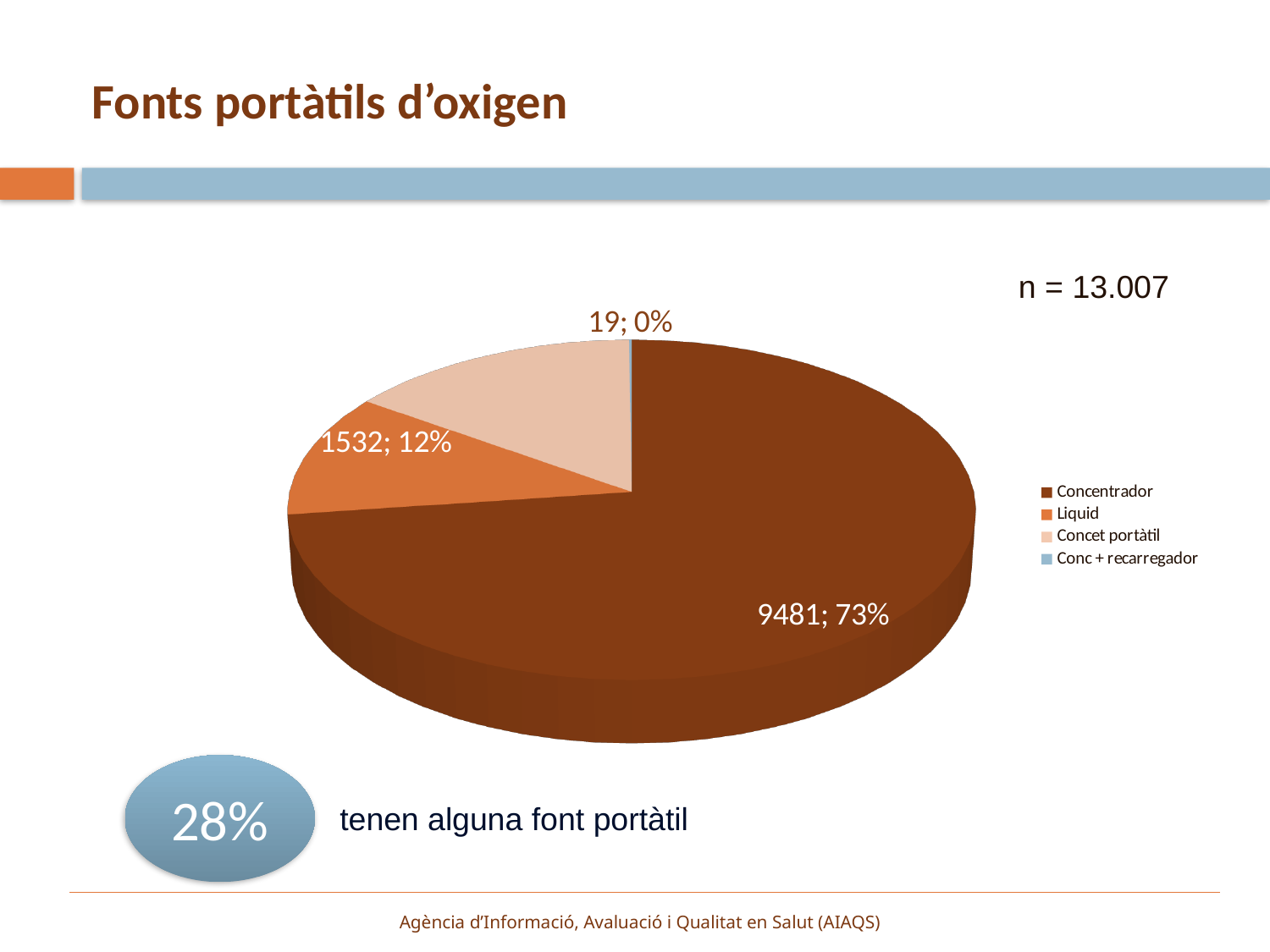
What value is shown for the Liquid slice? 1532 How many categories does the pie chart's legend list? 4 What kind of chart is shown on the slide? pie chart What value is shown for the Concentrador slice? 9481 What percentage share of the pie does Concentrador have? 73% What is the difference between the Concentrador value and the Liquid value? 7949 What is the value of n shown next to the pie chart? 13.007 What percentage share of the pie does Liquid have? 12% What value is shown for the Conc + recarregador slice? 19 What is the title of the slide containing the pie chart? Fonts portàtils d'oxigen Which category has the largest slice of the pie? Concentrador Which category has the smallest slice of the pie? Conc + recarregador